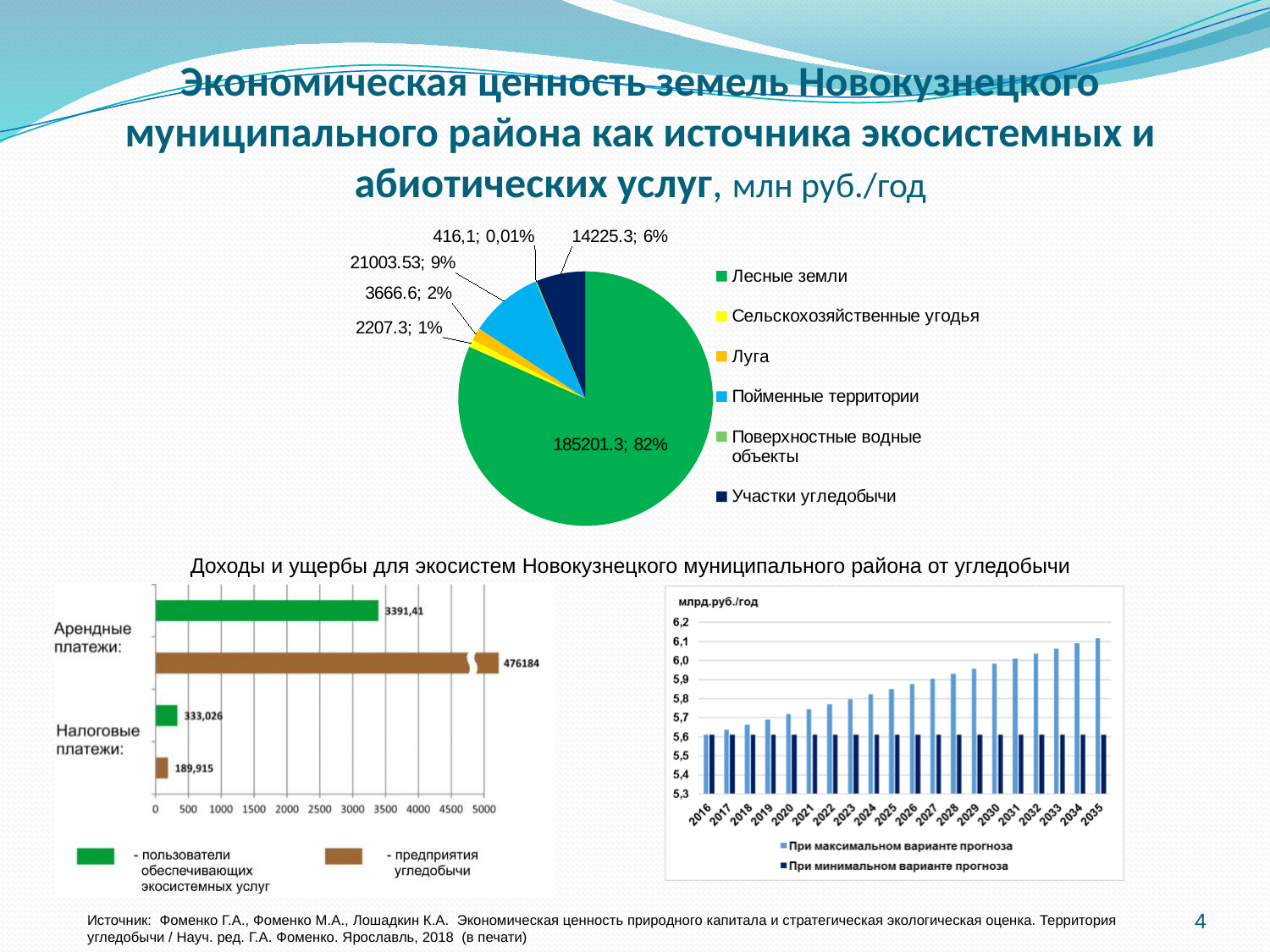
In the bottom-right chart, do the values for При максимальном варианте прогноза rise or fall from 2016 to 2035? rise In the bottom-left bar chart, what is the value of Налоговые платежи for пользователи обеспечивающих экосистемных услуг? 333,026 In the pie chart, which category has the largest slice? Лесные земли In the pie chart, which is larger: the value for Луга or the value for Сельскохозяйственные угодья? Луга In the pie chart, which category has the smallest slice? Поверхностные водные объекты In the pie chart, what value and share are shown for Лесные земли? 185201.3; 82% How many categories does the legend of the pie chart list? 6 In the pie chart, what share of the total do Участки угледобычи account for? 6% What type of chart is the bottom-left chart showing Арендные платежи and Налоговые платежи? bar chart In the pie chart, what value is shown for Пойменные территории? 21003.53 In the bottom-left bar chart, what is the value of Арендные платежи for предприятия угледобычи? 476184 In the bottom-right chart, how many years are shown on the x axis? 20